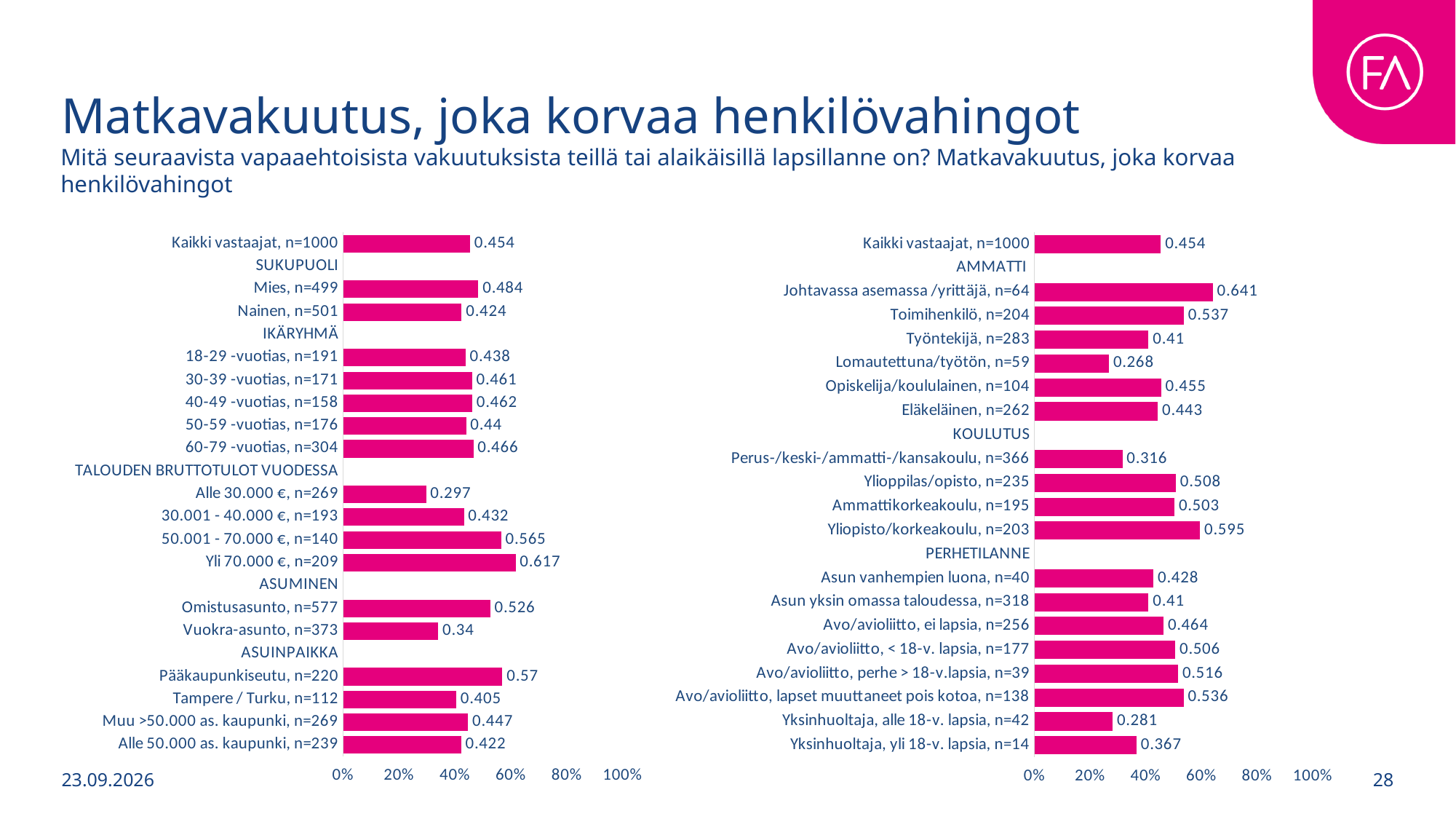
In the right chart, which is larger: the value for Toimihenkilö, n=204 or the value for Työntekijä, n=283? Toimihenkilö, n=204 In the left chart, which category has the lowest value? Alle 30.000 €, n=269 In the right chart, what is the value for Lomautettuna/työtön, n=59? 0.268 In the left chart, what is the difference between the values for Mies, n=499 and Nainen, n=501? 0.06 In the left chart, is the value for Pääkaupunkiseutu, n=220 greater or less than 40%? greater In the left chart, what is the value for Vuokra-asunto, n=373? 0.34 In the left chart, which category has the highest value? Yli 70.000 €, n=209 In the right chart, which category has the highest value? Johtavassa asemassa /yrittäjä, n=64 In the right chart, what is the value for Yliopisto/korkeakoulu, n=203? 0.595 In the left chart, what is the value for Mies, n=499? 0.484 In the right chart, which category has the lowest value? Lomautettuna/työtön, n=59 What kind of chart is shown on the left of the slide? bar chart